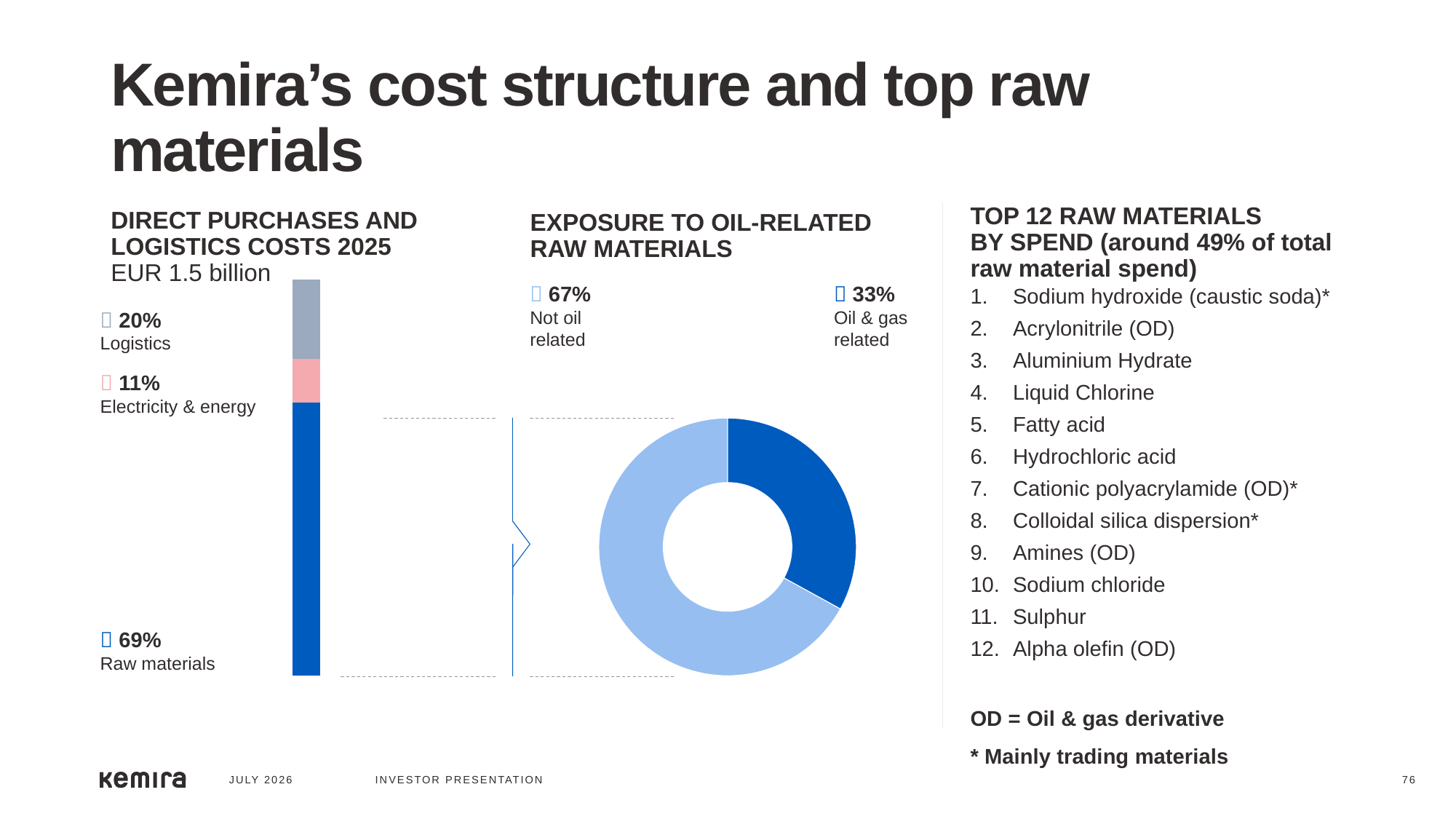
In the 'Exposure to oil-related raw materials' chart, which is larger: Not oil related or Oil & gas related? Not oil related In the 'Direct purchases and logistics costs 2025' chart, which category has the smallest share? Electricity & energy In the 'Direct purchases and logistics costs 2025' chart, what share is Electricity & energy? 11% In the 'Direct purchases and logistics costs 2025' chart, how many cost categories are shown in the stacked bar? 3 In the 'Exposure to oil-related raw materials' chart, what share is Not oil related? 67% In the 'Direct purchases and logistics costs 2025' chart, what share is Logistics? 20% What kind of chart is the 'Exposure to oil-related raw materials' chart? Donut (pie) chart In the 'Direct purchases and logistics costs 2025' chart, what share is Raw materials? 69% In the 'Direct purchases and logistics costs 2025' chart, what is the difference between the Raw materials share and the Logistics share? 49 percentage points What kind of chart is the 'Direct purchases and logistics costs 2025' chart? Stacked bar chart In the 'Exposure to oil-related raw materials' chart, what share is Oil & gas related? 33% In the 'Direct purchases and logistics costs 2025' chart, which category has the largest share? Raw materials